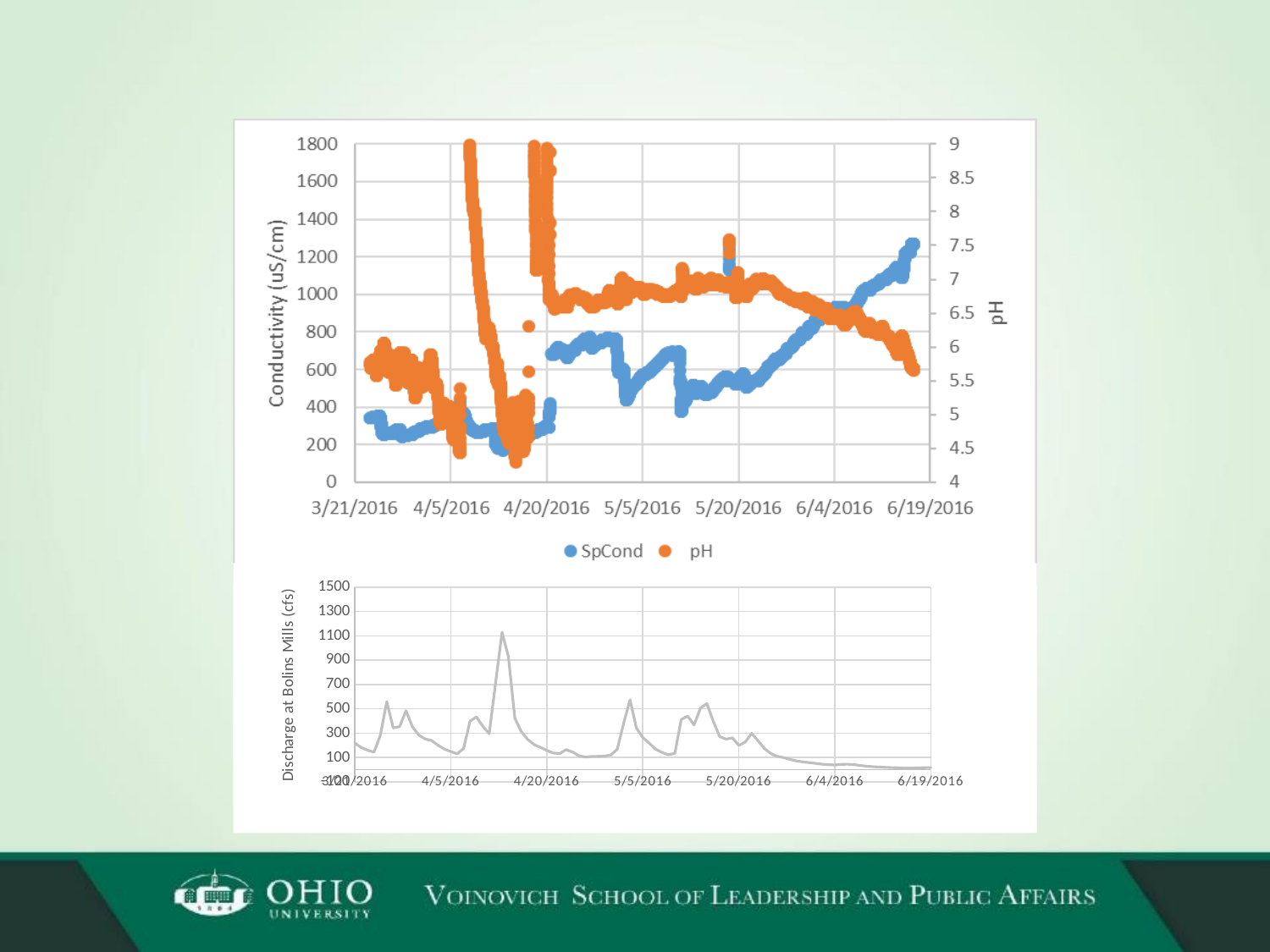
In the bottom chart, is the highest discharge peak greater or less than 900 cfs? greater What is the label of the vertical axis of the bottom chart? Discharge at Bolins Mills (cfs) In the bottom chart, is the discharge at 6/19/2016 greater or less than 100 cfs? less In the top chart, is the SpCond value near 6/19/2016 greater or less than 1000 uS/cm? greater In the top chart, what are the two series named in the legend? SpCond and pH What kind of chart is the bottom chart? Line chart In the top chart, does SpCond rise or fall between 5/20/2016 and 6/19/2016? rise In the top chart, does pH rise or fall between 5/20/2016 and 6/19/2016? fall In the top chart, how many series does the legend list? 2 In the top chart, what colour are the pH points? Orange